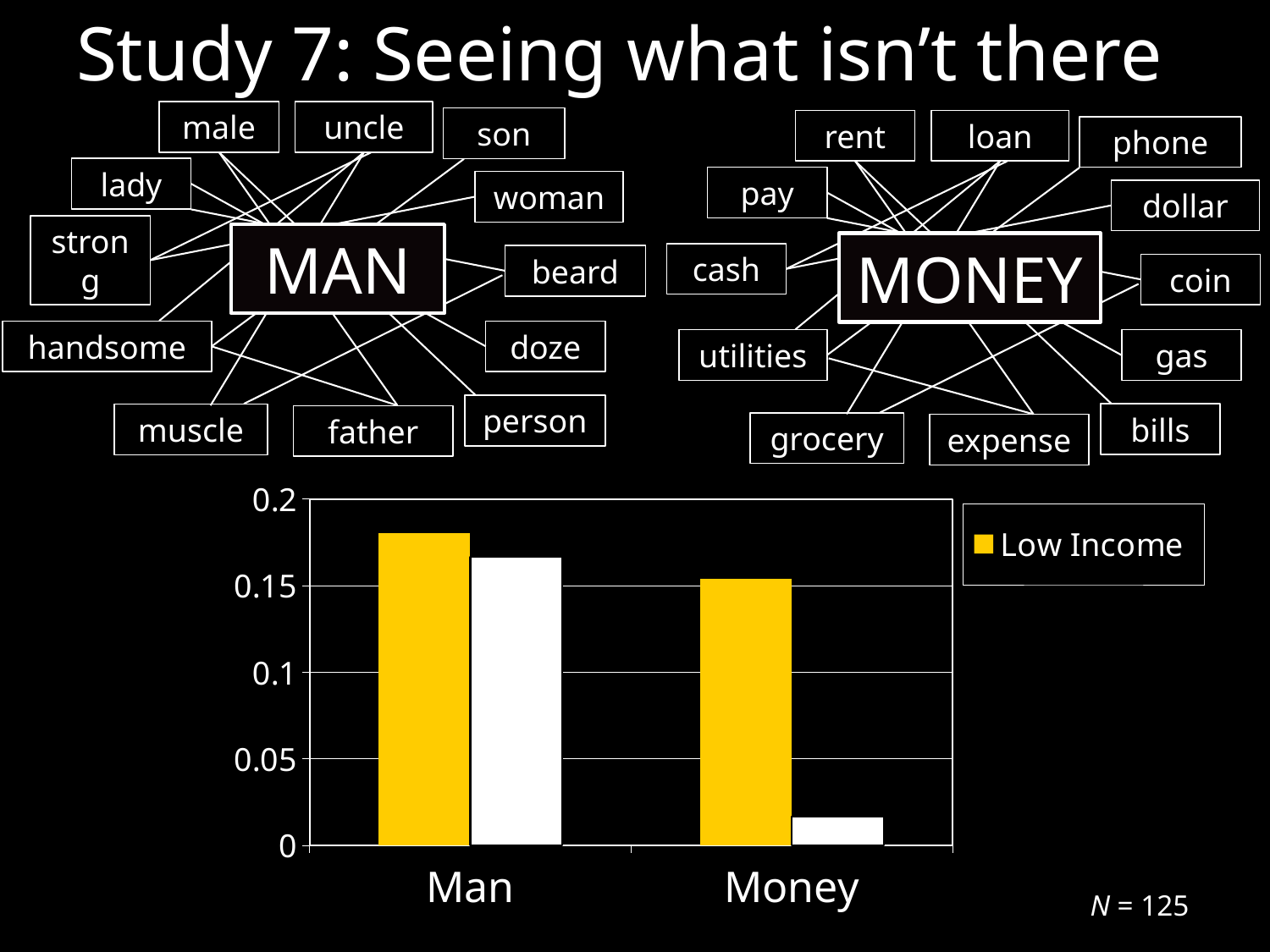
Is the value of the white bar for Money greater or less than 0.05? less Which category has the higher Low Income value, Man or Money? Man How many categories are shown on the x axis of the bar chart? 2 For the Man category, which bar is taller, the yellow Low Income bar or the white bar? the yellow Low Income bar Is the Low Income value for Man greater or less than 0.15? greater Is the value of the white bar for Man greater or less than 0.15? greater Which category has the taller white bar, Man or Money? Man Which category has the highest Low Income bar? Man What kind of chart is shown at the bottom of the slide? bar chart What colour are the Low Income bars in the chart? yellow Which series is named in the legend of the bar chart? Low Income